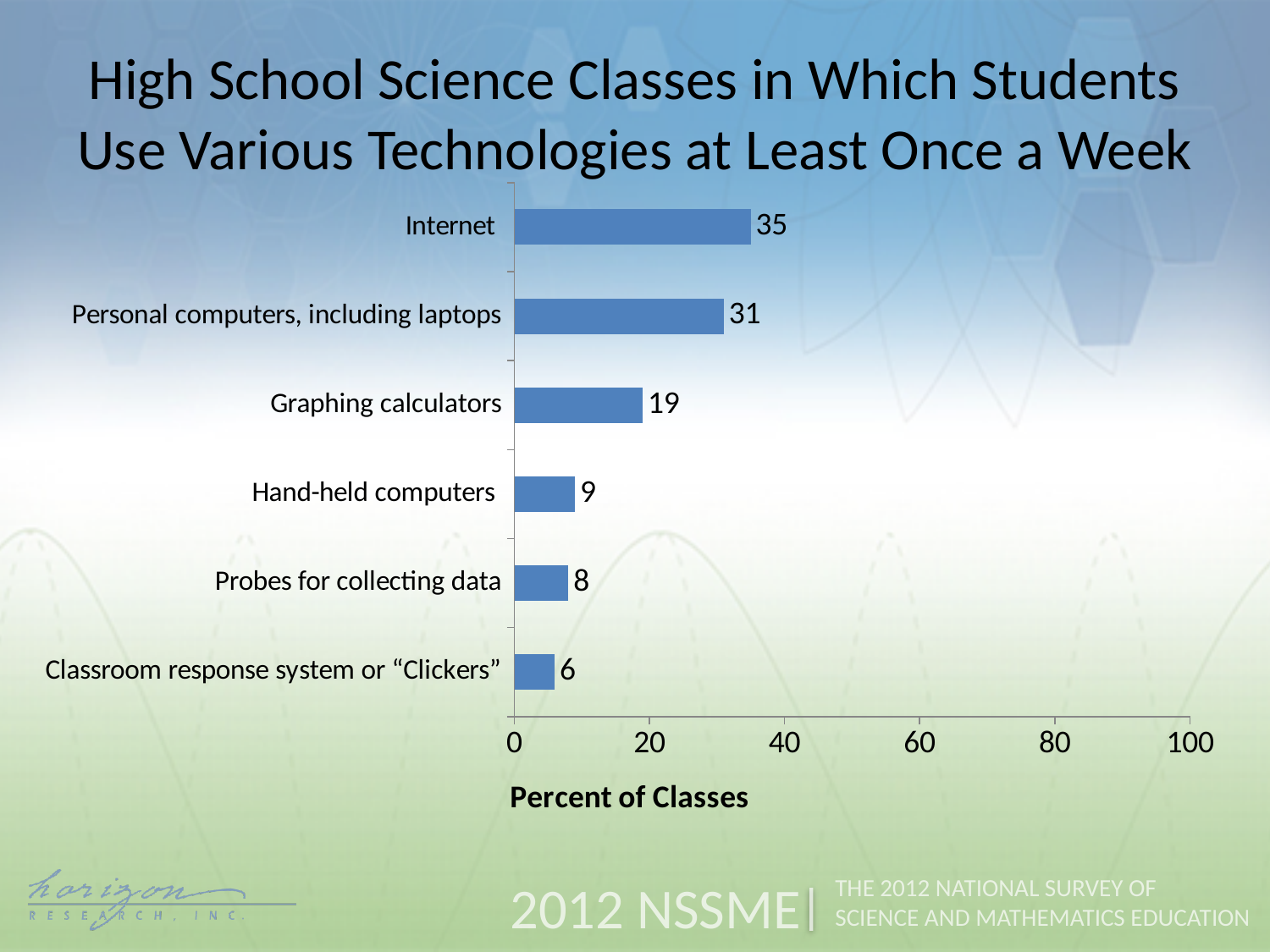
What kind of chart is shown on the slide? bar chart Which technology has the highest percent of classes? Internet What is the value for Graphing calculators? 19 What is the difference between the values for Graphing calculators and Hand-held computers? 10 What is the value for Probes for collecting data? 8 What percent of classes use the Internet at least once a week? 35 Which technology has the lowest percent of classes? Classroom response system or "Clickers" How many technology categories are shown in the chart? 6 Is the value for Personal computers, including laptops greater or less than 40? less What is the difference between the values for Internet and Personal computers, including laptops? 4 What is the label of the horizontal axis? Percent of Classes Which is larger, the value for Hand-held computers or the value for Probes for collecting data? Hand-held computers